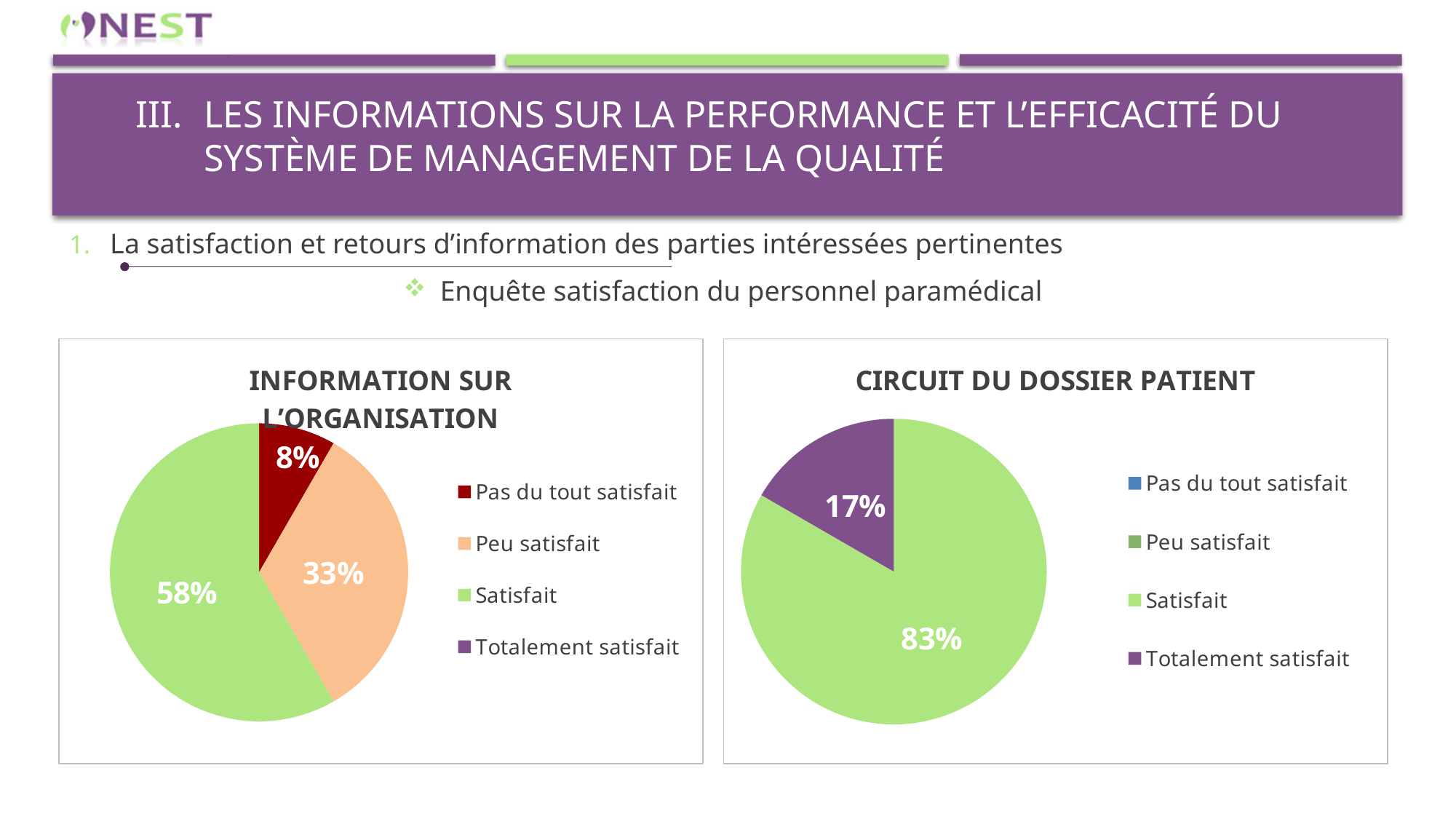
In the 'CIRCUIT DU DOSSIER PATIENT' chart, what share is labelled for the 'Totalement satisfait' slice? 17% In the 'INFORMATION SUR L'ORGANISATION' chart, what share is labelled for the 'Pas du tout satisfait' slice? 8% Which is larger in the 'INFORMATION SUR L'ORGANISATION' chart: the 'Peu satisfait' slice or the 'Pas du tout satisfait' slice? Peu satisfait In the 'CIRCUIT DU DOSSIER PATIENT' chart, what share is labelled for the 'Satisfait' slice? 83% In the 'INFORMATION SUR L'ORGANISATION' chart, what share is labelled for the 'Satisfait' slice? 58% In the 'CIRCUIT DU DOSSIER PATIENT' chart, which category has the smallest visible slice? Totalement satisfait In the 'INFORMATION SUR L'ORGANISATION' chart, what is the difference between the 'Satisfait' and 'Peu satisfait' shares? 25% In the 'INFORMATION SUR L'ORGANISATION' chart, which category has the largest slice? Satisfait In the 'INFORMATION SUR L'ORGANISATION' chart, what share is labelled for the 'Peu satisfait' slice? 33% In the 'CIRCUIT DU DOSSIER PATIENT' chart, what is the difference between the 'Satisfait' and 'Totalement satisfait' shares? 66% How many entries does the legend of the 'INFORMATION SUR L'ORGANISATION' chart list? 4 What type of chart is the 'CIRCUIT DU DOSSIER PATIENT' chart? Pie chart